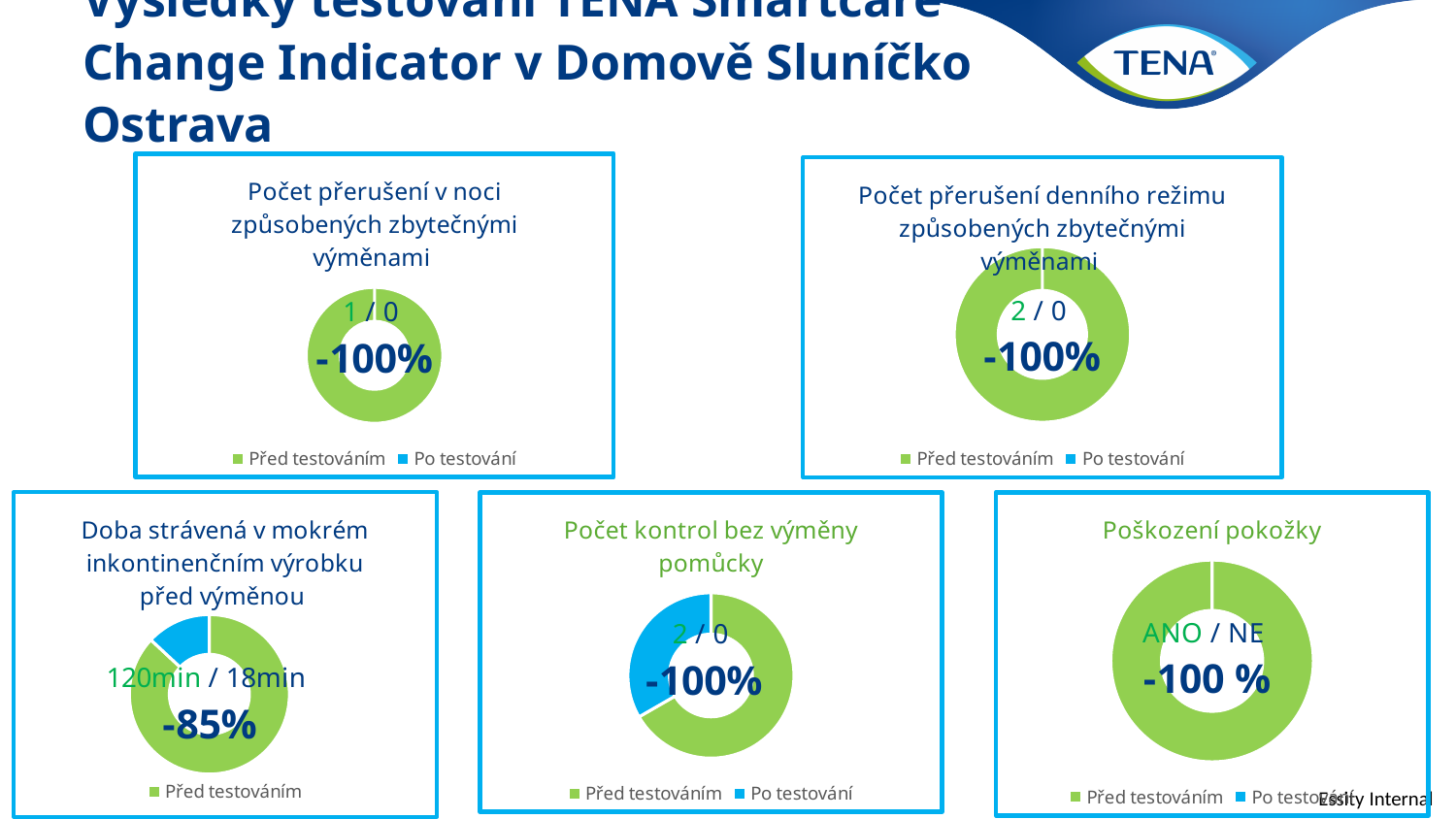
In the 'Počet přerušení v noci způsobených zbytečnými výměnami' chart, what is the value before testing? 1 In the 'Doba strávená v mokrém inkontinenčním výrobku před výměnou' chart, what is the value after testing? 18min In the 'Počet přerušení denního režimu způsobených zbytečnými výměnami' chart, what is the value before testing? 2 What percentage change is printed in the centre of the 'Počet kontrol bez výměny pomůcky' chart? -100% How many series does the legend of the 'Počet kontrol bez výměny pomůcky' chart list? 2 What are the two legend entries in the 'Počet přerušení v noci způsobených zbytečnými výměnami' chart? Před testováním, Po testování In the 'Doba strávená v mokrém inkontinenčním výrobku před výměnou' chart, which is larger: the value before testing or after testing? Before testing (120min) In the 'Doba strávená v mokrém inkontinenčním výrobku před výměnou' chart, what is the value before testing (Před testováním)? 120min What kind of chart is used in the 'Počet přerušení v noci způsobených zbytečnými výměnami' panel? Donut (pie) chart What text is printed in the centre of the 'Poškození pokožky' chart above the percentage? ANO / NE How many donut charts are shown on the slide? 5 What percentage change is printed in the centre of the 'Doba strávená v mokrém inkontinenčním výrobku před výměnou' chart? -85%